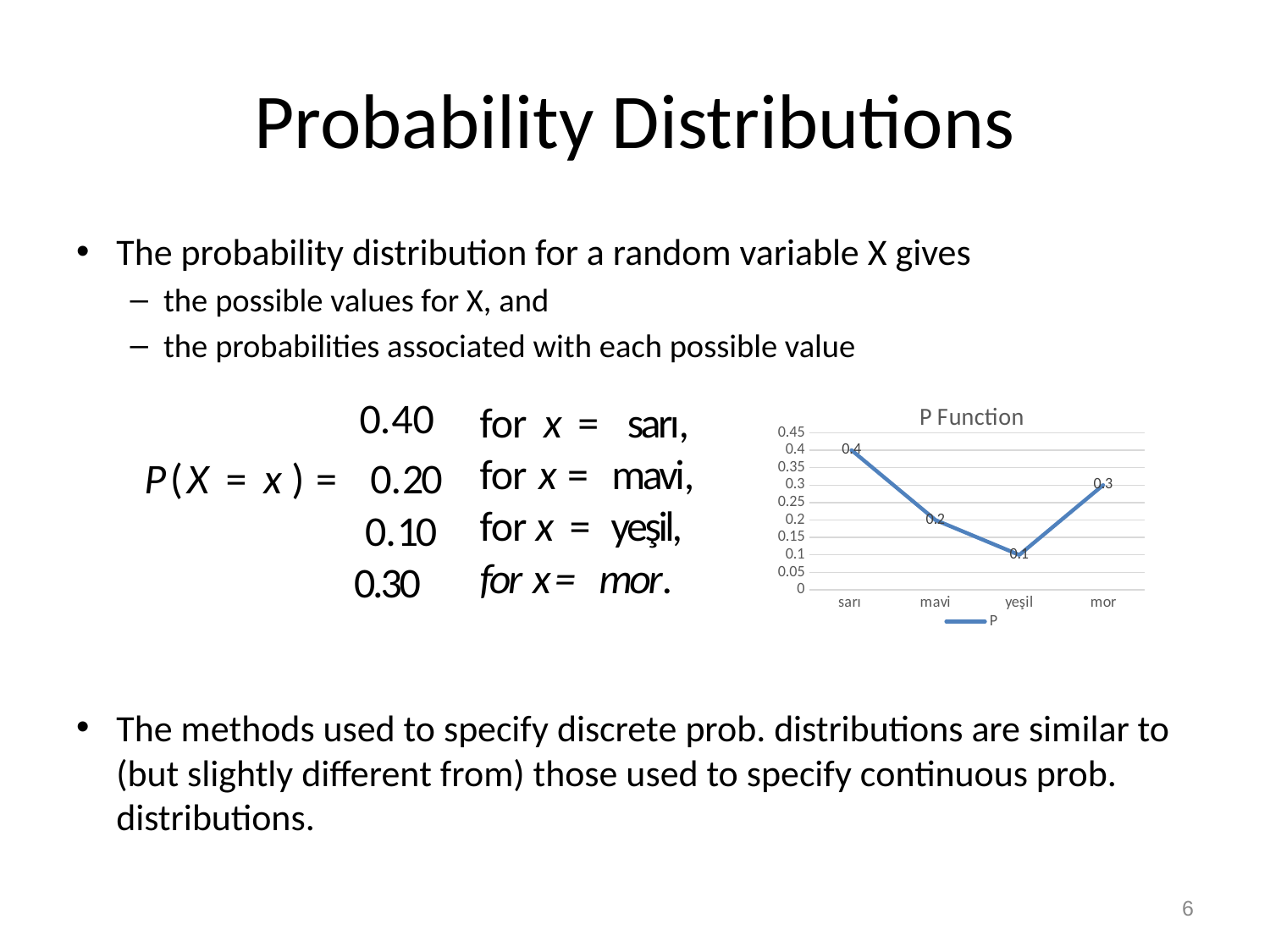
Which is larger in the P Function chart, the value for mavi or the value for mor? mor What is the difference between the values for sarı and mor in the P Function chart? 0.1 What is the value for mor in the P Function chart? 0.3 Which category has the lowest value in the P Function chart? yeşil How many categories are shown on the x axis of the P Function chart? 4 What is the title of the chart on the slide? P Function What is the value for yeşil in the P Function chart? 0.1 What is the value for sarı in the P Function chart? 0.4 Which category has the highest value in the P Function chart? sarı What is the value for mavi in the P Function chart? 0.2 What kind of chart is the P Function chart? line chart How many series does the legend of the P Function chart list? 1